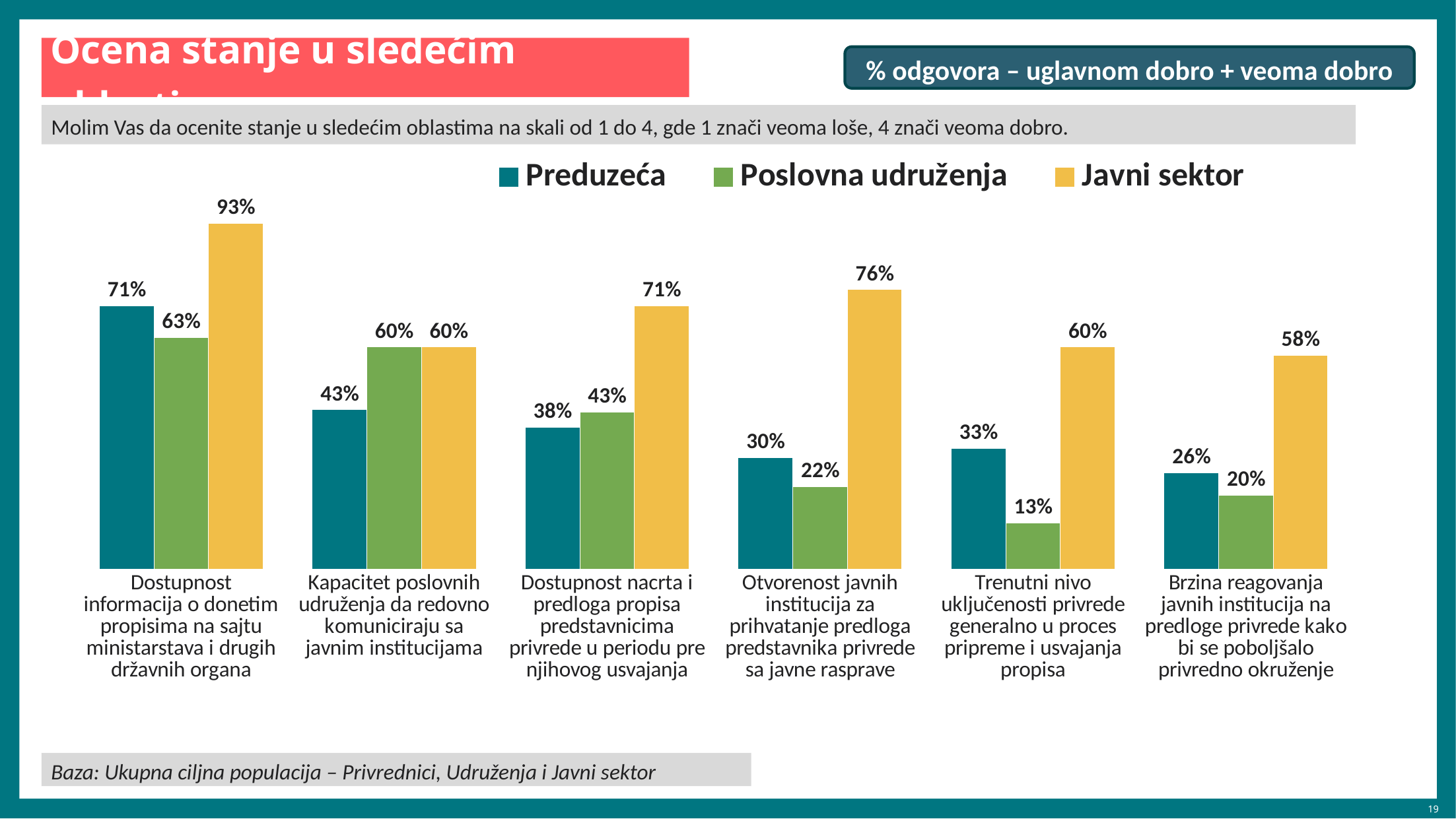
What is the difference between the Javni sektor and Preduzeća values for "Otvorenost javnih institucija za prihvatanje predloga predstavnika privrede sa javne rasprave"? 46% What is the difference between the Preduzeća and Poslovna udruženja values for "Brzina reagovanja javnih institucija na predloge privrede kako bi se poboljšalo privredno okruženje"? 6% What kind of chart is shown on the slide? Bar chart For "Kapacitet poslovnih udruženja da redovno komuniciraju sa javnim institucijama", which is larger: the Preduzeća value or the Poslovna udruženja value? Poslovna udruženja Which category has the lowest Poslovna udruženja value? Trenutni nivo uključenosti privrede generalno u proces pripreme i usvajanja propisa Which series is shown in yellow in the legend? Javni sektor Which category has the highest Preduzeća value? Dostupnost informacija o donetim propisima na sajtu ministarstava i drugih državnih organa What is the Preduzeća value for "Trenutni nivo uključenosti privrede generalno u proces pripreme i usvajanja propisa"? 33% How many series does the legend list? 3 What is the Javni sektor value for "Dostupnost informacija o donetim propisima na sajtu ministarstava i drugih državnih organa"? 93% What is the Poslovna udruženja value for "Otvorenost javnih institucija za prihvatanje predloga predstavnika privrede sa javne rasprave"? 22% How many categories are shown on the x axis of the chart? 6